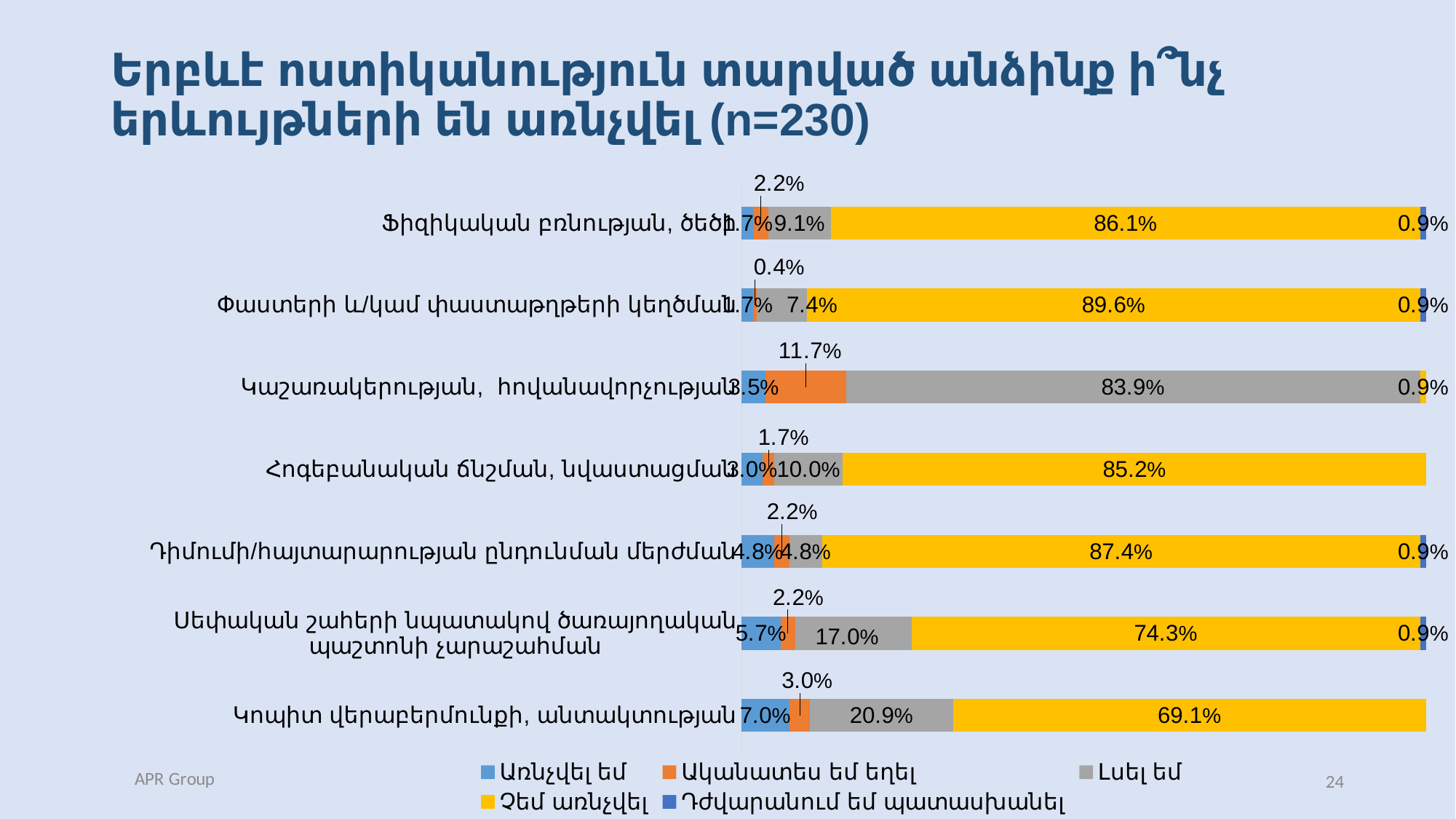
Which category has the highest value for "Չեմ առնչվել"? Փաստերի և/կամ փաստաթղթերի կեղծման How many series does the legend list? 5 Which category has the lowest value for "Ականատես եմ եղել"? Փաստերի և/կամ փաստաթղթերի կեղծման What is the value of "Առնչվել եմ" for "Սեփական շահերի նպատակով ծառայողական պաշտոնի չարաշահման"? 5.7% What is the value of "Ականատես եմ եղել" for "Կաշառակերության, հովանավորչության"? 11.7% Which is larger: the "Առնչվել եմ" value for "Կոպիտ վերաբերմունքի, անտակտության" or for "Սեփական շահերի նպատակով ծառայողական պաշտոնի չարաշահման"? Կոպիտ վերաբերմունքի, անտակտության What kind of chart is shown on the slide? Stacked bar chart What is the difference in "Լսել եմ" between "Կոպիտ վերաբերմունքի, անտակտության" and "Սեփական շահերի նպատակով ծառայողական պաշտոնի չարաշահման"? 3.9 percentage points Which category has the highest value for "Առնչվել եմ"? Կոպիտ վերաբերմունքի, անտակտության What is the value of "Չեմ առնչվել" for "Փաստերի և/կամ փաստաթղթերի կեղծման"? 89.6% How many categories are shown in the chart? 7 What is the value of "Լսել եմ" for "Կոպիտ վերաբերմունքի, անտակտության"? 20.9%